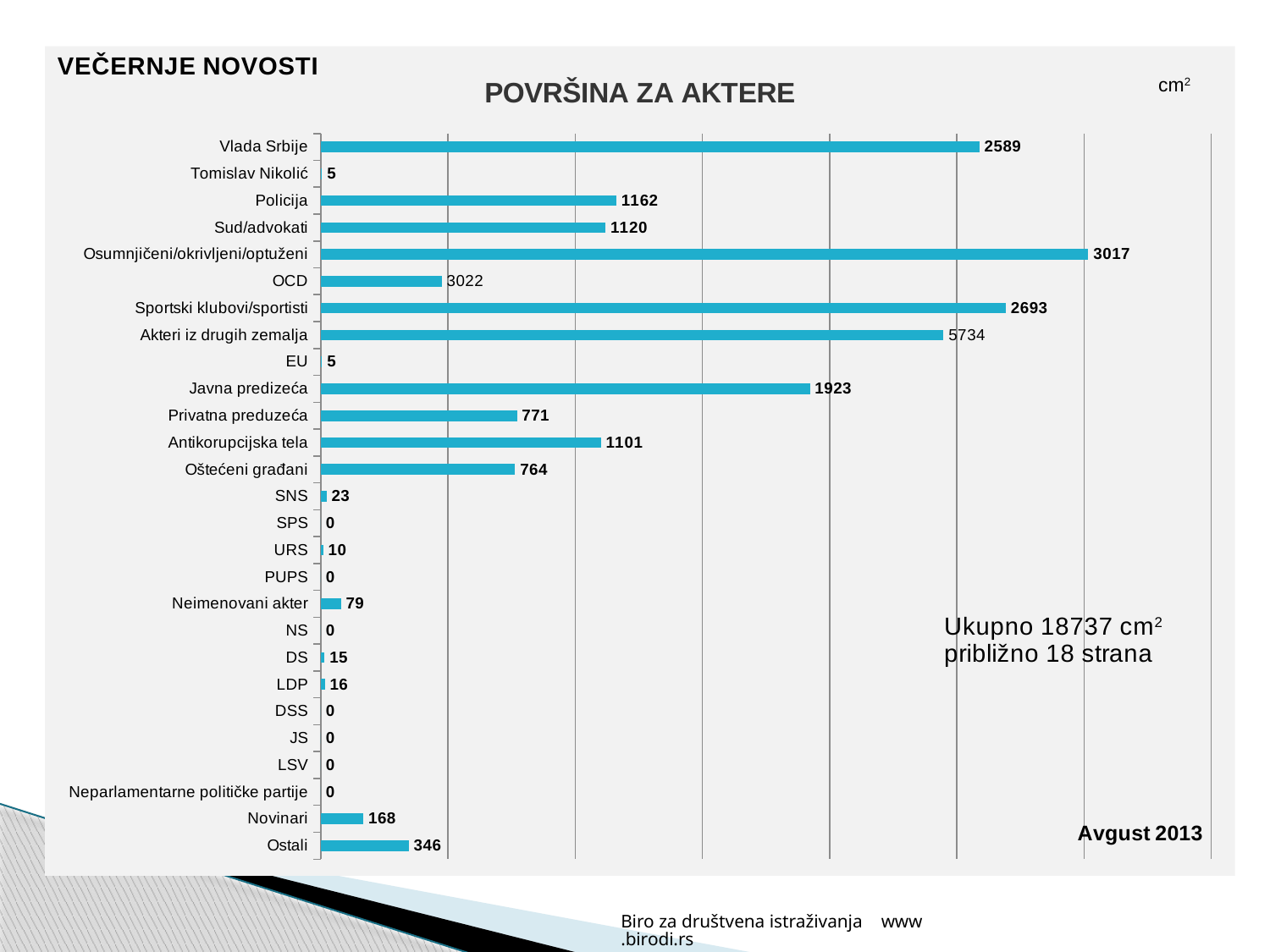
What is the value for Novinari? 168 How many categories are shown on the chart? 27 What is the title of the chart? POVRŠINA ZA AKTERE What is the value for Javna predizeća? 1923 What is the difference between the values for Policija and Sud/advokati? 42 What is the value for Antikorupcijska tela? 1101 What is the difference between the values for Ostali and Novinari? 178 What is the value for Vlada Srbije? 2589 Which has a larger value, Privatna preduzeća or Oštećeni građani? Privatna preduzeća What is the value for Policija? 1162 What type of chart is shown on the slide? bar chart What is the value for SNS? 23